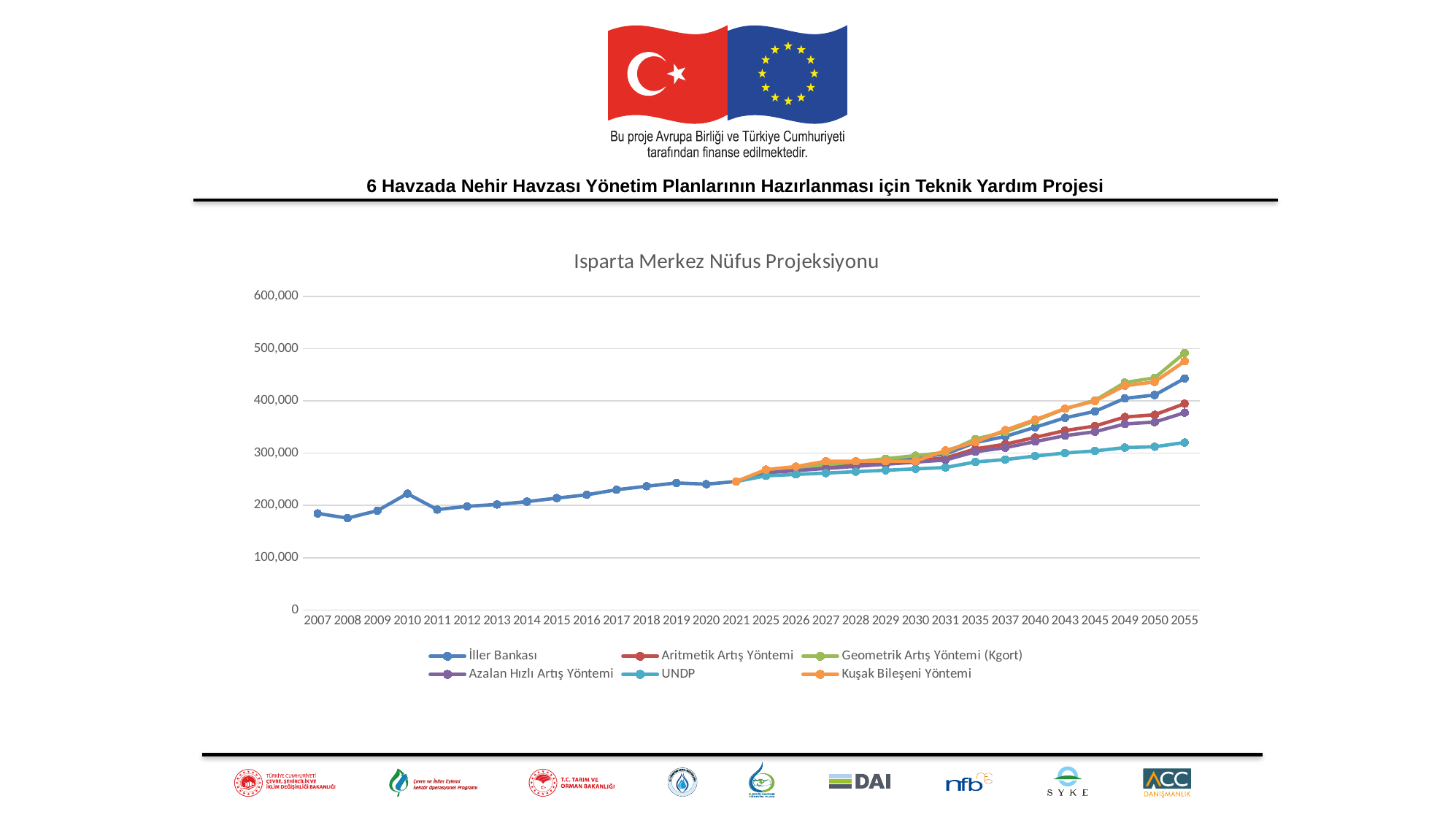
Is the Geometrik Artış Yöntemi (Kgort) value for 2055 greater or less than 400,000? greater Which series is drawn in green? Geometrik Artış Yöntemi (Kgort) Is the İller Bankası value for 2007 greater or less than 200,000? less How many years are shown on the x axis? 30 Which series has the highest value in 2055? Geometrik Artış Yöntemi (Kgort) Which series has the lowest value in 2055? UNDP Is the UNDP value for 2055 greater or less than 400,000? less What is the title of the chart? Isparta Merkez Nüfus Projeksiyonu What kind of chart is shown on the slide? line chart Which is larger for İller Bankası: the value in 2010 or the value in 2011? 2010 How many series does the legend list? 6 Does the İller Bankası series generally rise or fall from 2007 to 2055? rise